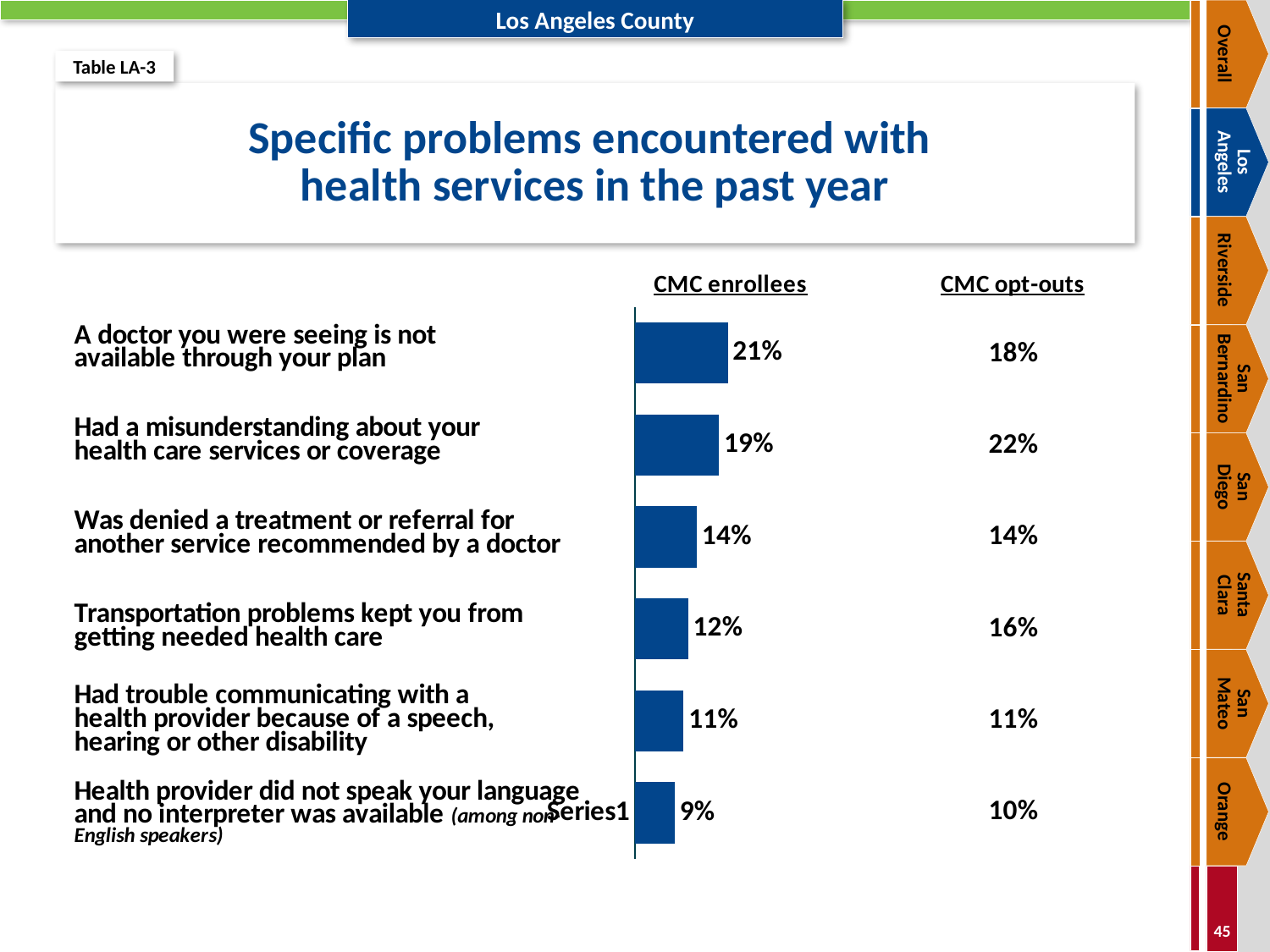
What is the CMC enrollees value for 'Transportation problems kept you from getting needed health care'? 12% Do the CMC enrollees bar values rise or fall from the top category to the bottom category? fall What kind of chart is shown on the slide? bar chart Which problem has the lowest CMC enrollees value? Health provider did not speak your language and no interpreter was available What is the title of the chart? Specific problems encountered with health services in the past year What is the difference between the CMC enrollees values for 'A doctor you were seeing is not available through your plan' and 'Had a misunderstanding about your health care services or coverage'? 2% Which has a larger CMC enrollees value: 'Was denied a treatment or referral for another service recommended by a doctor' or 'Had trouble communicating with a health provider because of a speech, hearing or other disability'? Was denied a treatment or referral for another service recommended by a doctor What is the CMC enrollees value for 'Health provider did not speak your language and no interpreter was available'? 9% How many problem categories are plotted in the bar chart? 6 Which problem has the highest CMC enrollees value? A doctor you were seeing is not available through your plan What is the CMC opt-outs value for 'Had a misunderstanding about your health care services or coverage'? 22% What is the CMC enrollees value for 'A doctor you were seeing is not available through your plan'? 21%